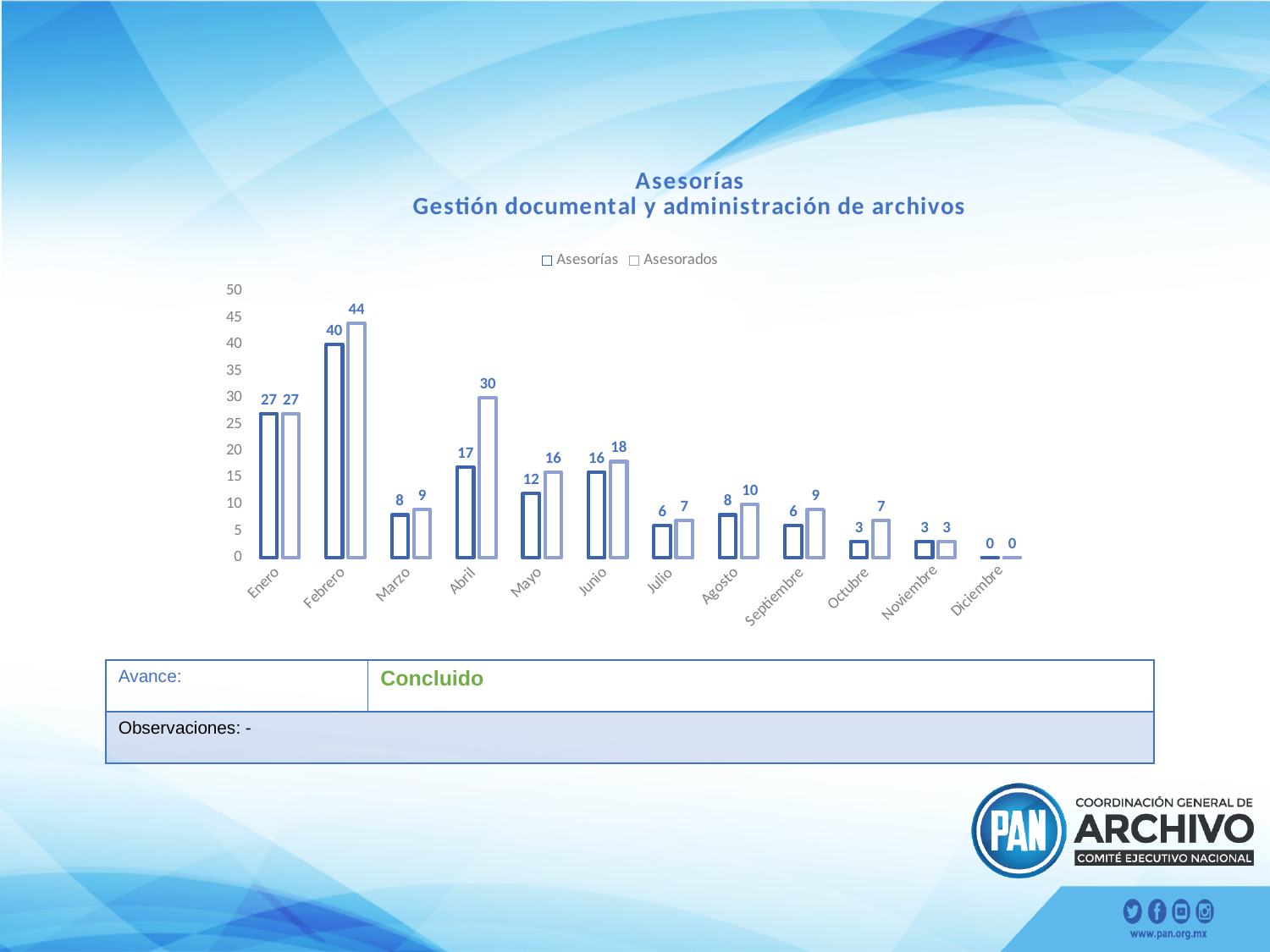
Which month has the highest value for Asesorados? Febrero Do the Asesorías values generally rise or fall from Febrero to Diciembre? Fall What is the difference between Asesorados and Asesorías in Abril? 13 How many months are shown on the x axis? 12 Which month has the lowest value for Asesorías? Diciembre Which is larger in Junio, Asesorías or Asesorados? Asesorados What is the value of Asesorías for Septiembre? 6 What is the value of Asesorados for Abril? 30 What kind of chart is shown on the slide? Bar chart What is the title of the chart? Asesorías Gestión documental y administración de archivos How many series does the legend list? 2 What is the value of Asesorías for Febrero? 40